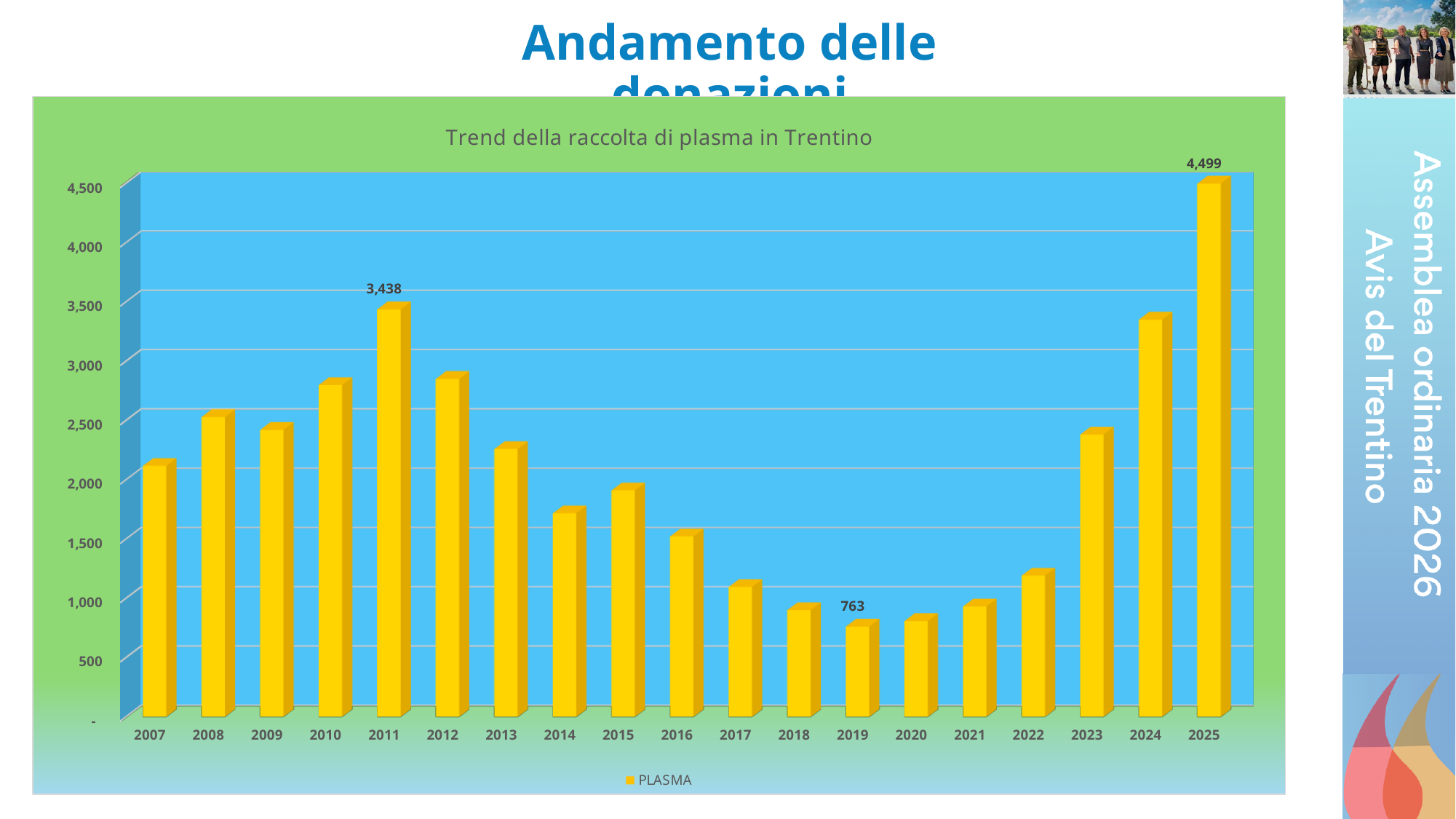
What is the plasma collection value for 2011? 3,438 Is the plasma value for 2016 greater or less than 2,000? less How many series does the chart legend list? 1 What is the difference between the plasma values for 2011 and 2019? 2,675 Which year has the highest plasma collection value? 2025 Which year has the lowest plasma collection value? 2019 How many years are shown on the x axis of the chart? 19 What is the plasma collection value for 2019? 763 What type of chart is shown on the slide? bar chart What is the difference between the plasma values for 2025 and 2011? 1,061 Which year has the larger plasma value, 2023 or 2024? 2024 What is the plasma collection value for 2025? 4,499